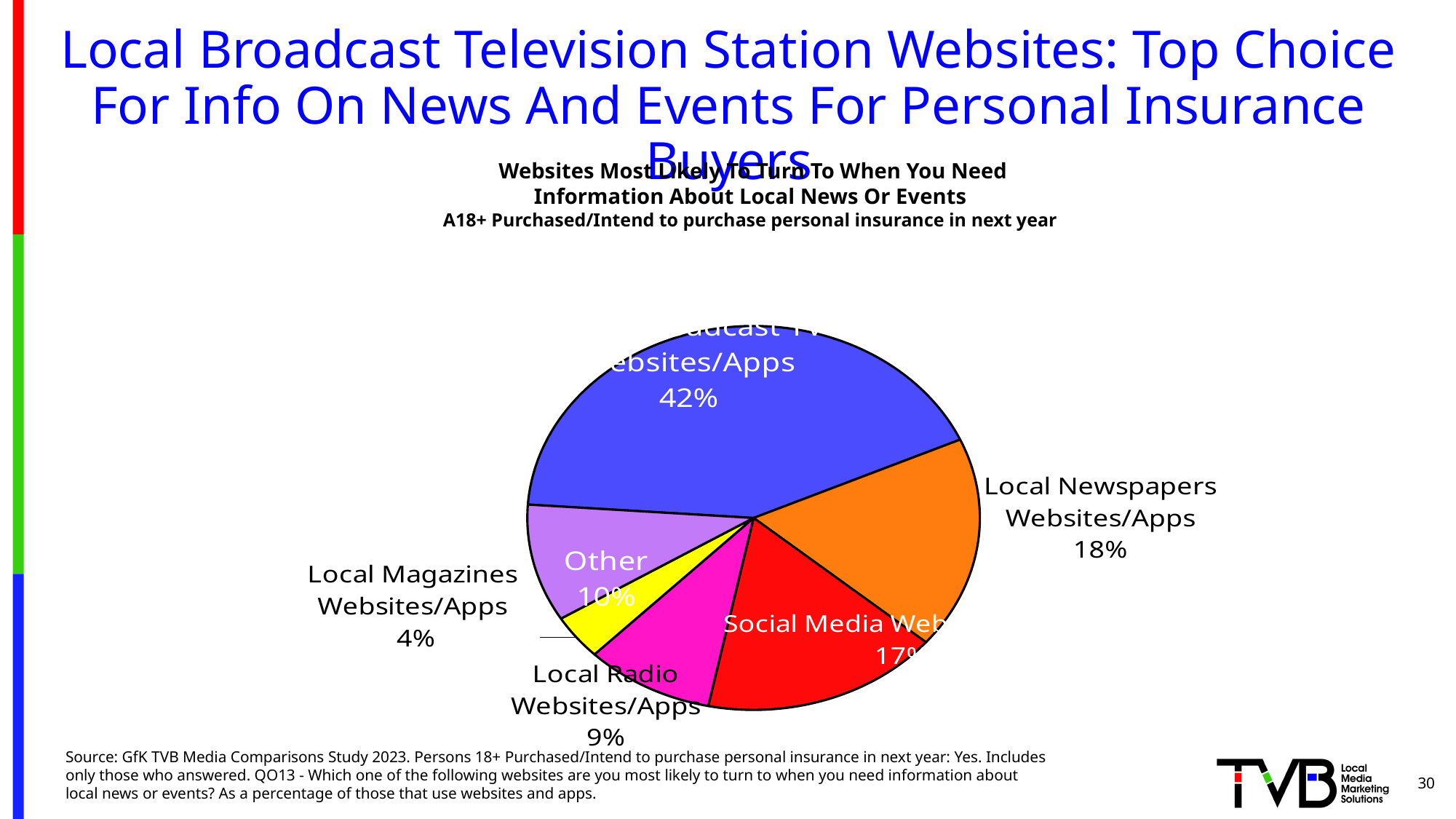
How many slices does the pie chart have? 6 What percentage is shown for Local Magazines Websites/Apps? 4% What percentage of personal insurance buyers turn to Local Newspapers Websites/Apps for local news or events? 18% What is the difference in percentage points between Local Newspapers Websites/Apps and Local Radio Websites/Apps? 9 Which audience does the chart subtitle say the data covers? A18+ Purchased/Intend to purchase personal insurance in next year Which category has the largest slice of the pie? Broadcast TV Websites/Apps What percentage is shown for the Broadcast TV Websites/Apps slice? 42% Which category has the smallest slice of the pie? Local Magazines Websites/Apps What type of chart is shown on the slide? pie chart What share of the pie is Local Radio Websites/Apps? 9% What percentage is shown for the Other slice? 10% Which is larger: the Other slice or the Local Magazines Websites/Apps slice? Other